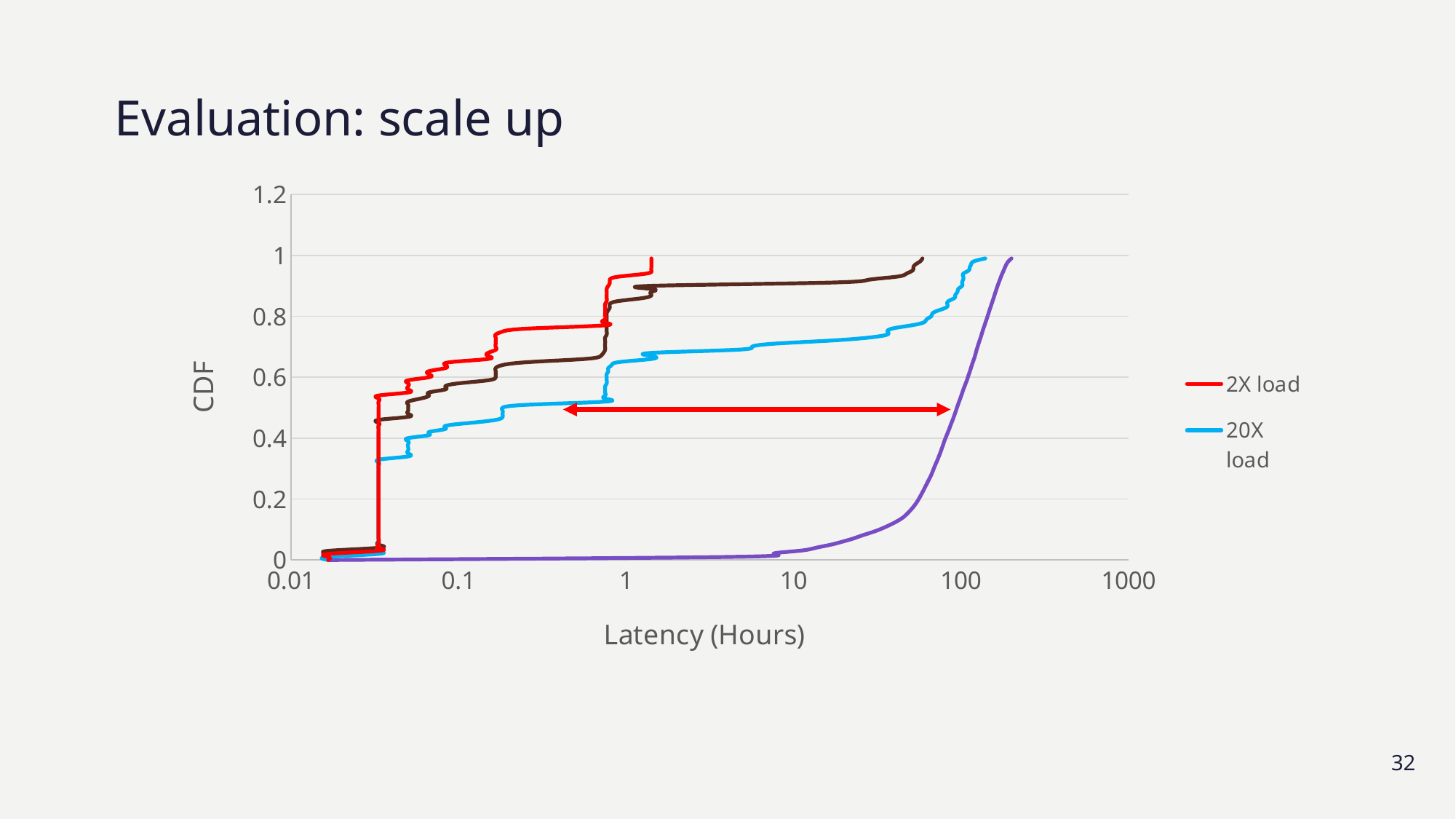
What is the label of the x axis? Latency (Hours) Is the CDF value for 20X load at a latency of 0.1 hours greater or less than 0.6? less Is the CDF value for 2X load at a latency of 1 hour greater or less than 0.8? greater How many series does the legend list? 2 At a latency of 1 hour, which series has the higher CDF value, 2X load or 20X load? 2X load Is the CDF value for 2X load at a latency of 0.1 hours greater or less than 0.4? greater Which of the two legend series reaches a CDF of 1 at the lower latency, 2X load or 20X load? 2X load How many tick labels are shown on the x axis? 6 Do the CDF values rise or fall as latency increases along the x axis? rise What kind of chart is shown on the slide? line chart What is the label of the y axis? CDF